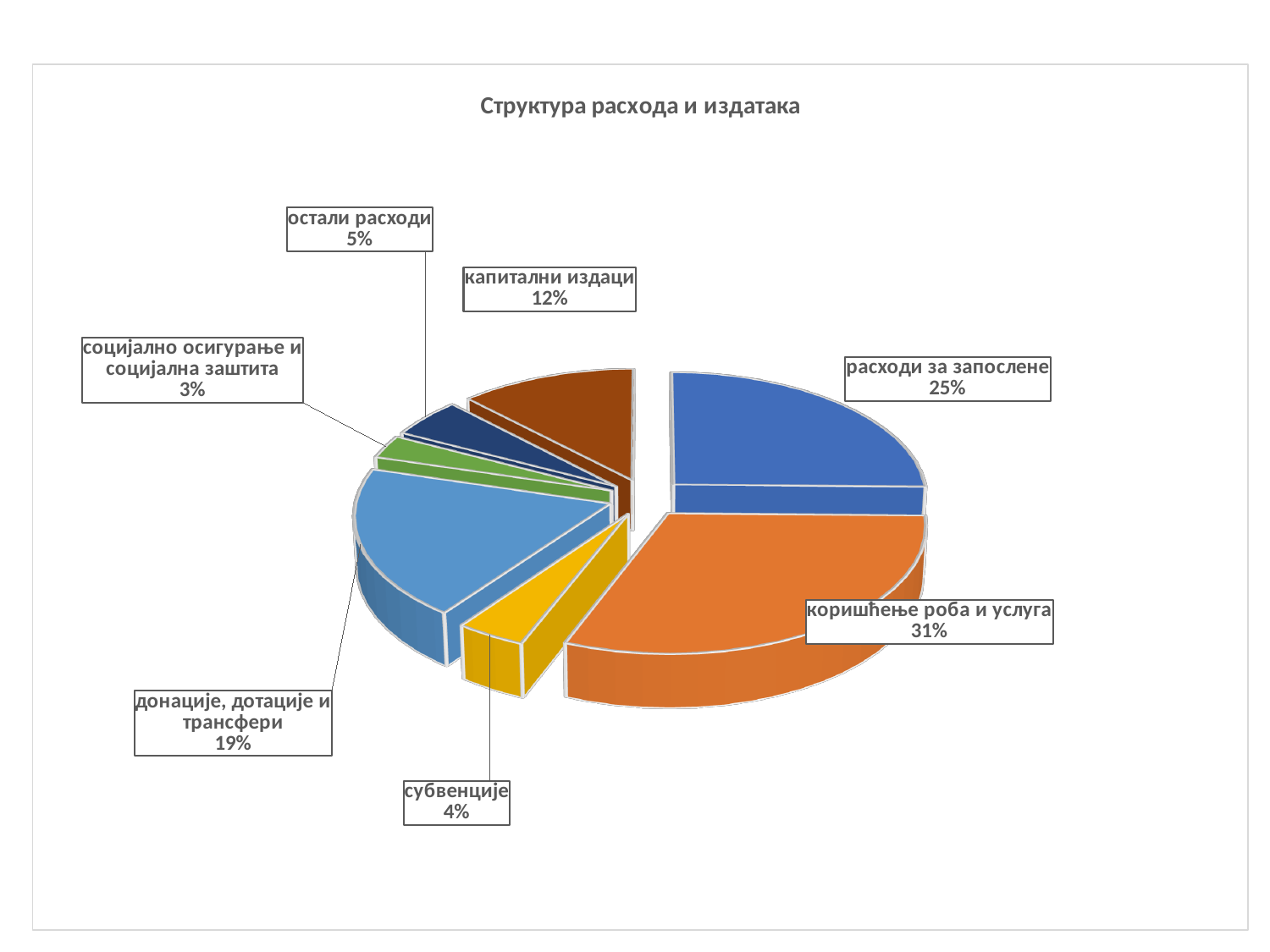
Which category has the largest share of the pie? коришћење роба и услуга Which is larger, остали расходи or субвенције? остали расходи What kind of chart is shown on the slide? pie chart What share does капитални издаци have? 12% What is the title of the chart? Структура расхода и издатака What share does субвенције have? 4% How many slices does the pie chart have? 7 What share does коришћење роба и услуга have? 31% Which category has the smallest share of the pie? социјално осигурање и социјална заштита What share does донације, дотације и трансфери have? 19% What is the difference in percentage points between коришћење роба и услуга and расходи за запослене? 6 What share does расходи за запослене have? 25%